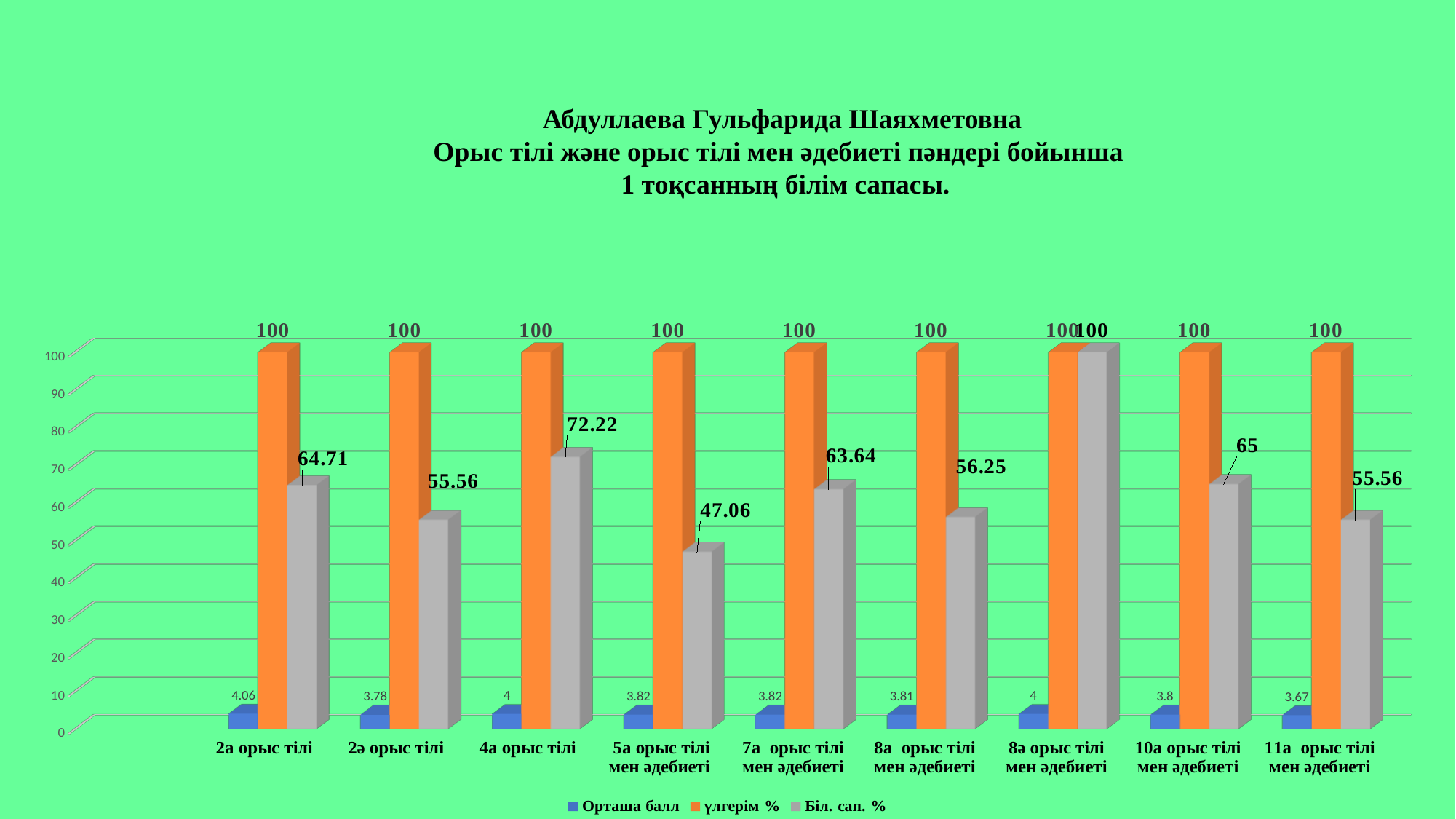
What is the Орташа балл value for 2а орыс тілі? 4.06 How many categories are shown on the x axis? 9 What is the Біл. сап. % value for 4а орыс тілі? 72.22 Which category has the lowest Біл. сап. % value? 5а орыс тілі мен әдебиеті Which category has the lowest Орташа балл value? 11а орыс тілі мен әдебиеті Which category has the highest Біл. сап. % value? 8ә орыс тілі мен әдебиеті What is the үлгерім % value for 10а орыс тілі мен әдебиеті? 100 Which is larger, the Біл. сап. % value for 7а орыс тілі мен әдебиеті or for 8а орыс тілі мен әдебиеті? 7а орыс тілі мен әдебиеті What kind of chart is shown on the slide? Bar chart How many series does the legend list? 3 What is the Біл. сап. % value for 5а орыс тілі мен әдебиеті? 47.06 What is the difference between the Біл. сап. % values for 4а орыс тілі and 2ә орыс тілі? 16.66